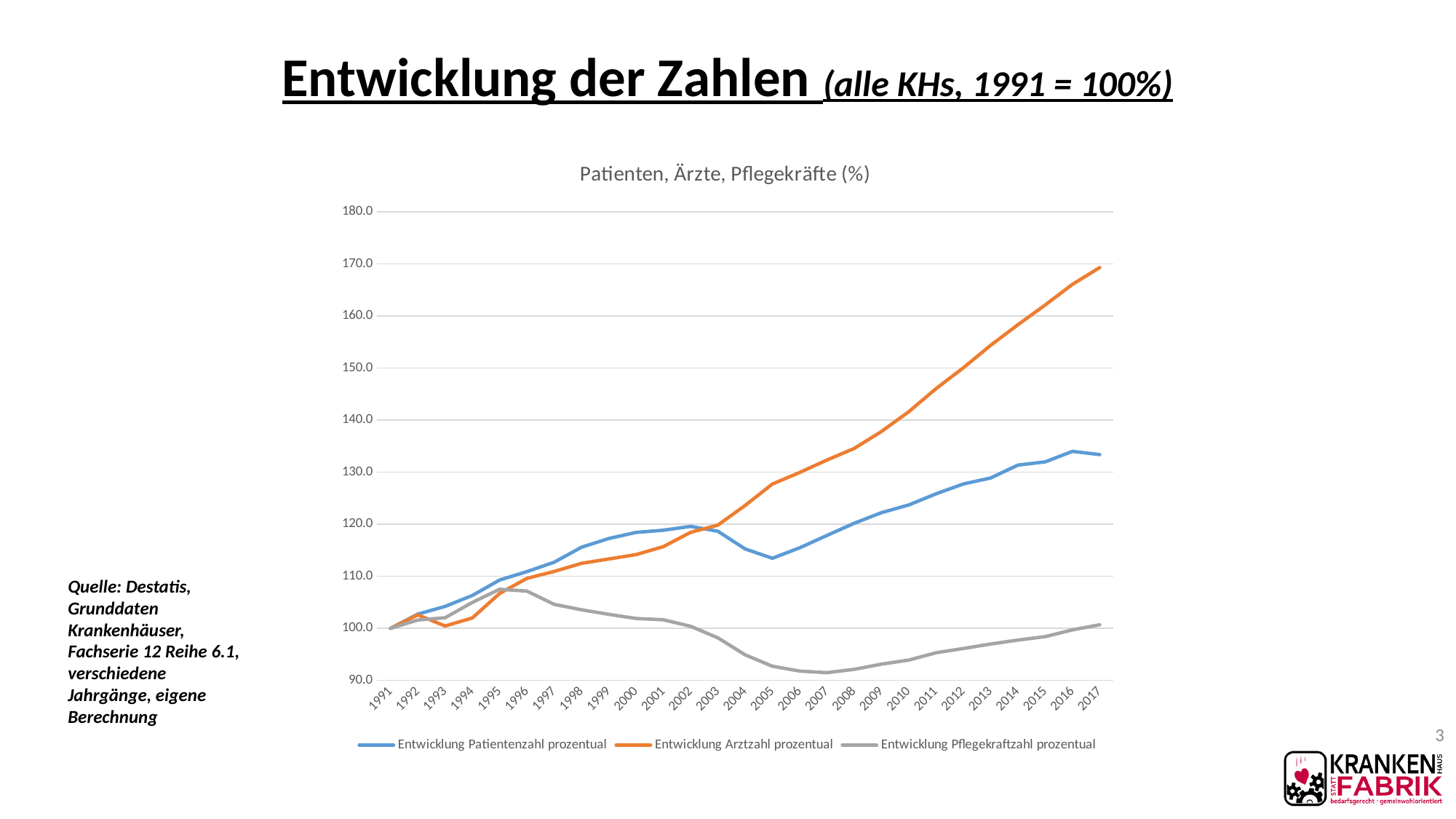
What kind of chart is shown on the slide? line chart Does Entwicklung Arztzahl prozentual generally rise or fall from 1991 to 2017? rise Is the value for Entwicklung Arztzahl prozentual in 2017 greater or less than 160.0? greater How many years are plotted along the x axis? 27 What is the value of Entwicklung Arztzahl prozentual in 1991? 100.0 Which series has the lowest value in 2017? Entwicklung Pflegekraftzahl prozentual Which series has the highest value in 2017? Entwicklung Arztzahl prozentual In 2017, which is larger: Entwicklung Patientenzahl prozentual or Entwicklung Arztzahl prozentual? Entwicklung Arztzahl prozentual Is the value for Entwicklung Pflegekraftzahl prozentual in 2007 greater or less than 100.0? less What is the title of the chart? Patienten, Ärzte, Pflegekräfte (%) Is the value for Entwicklung Patientenzahl prozentual in 2017 greater or less than 130.0? greater How many series does the legend list? 3